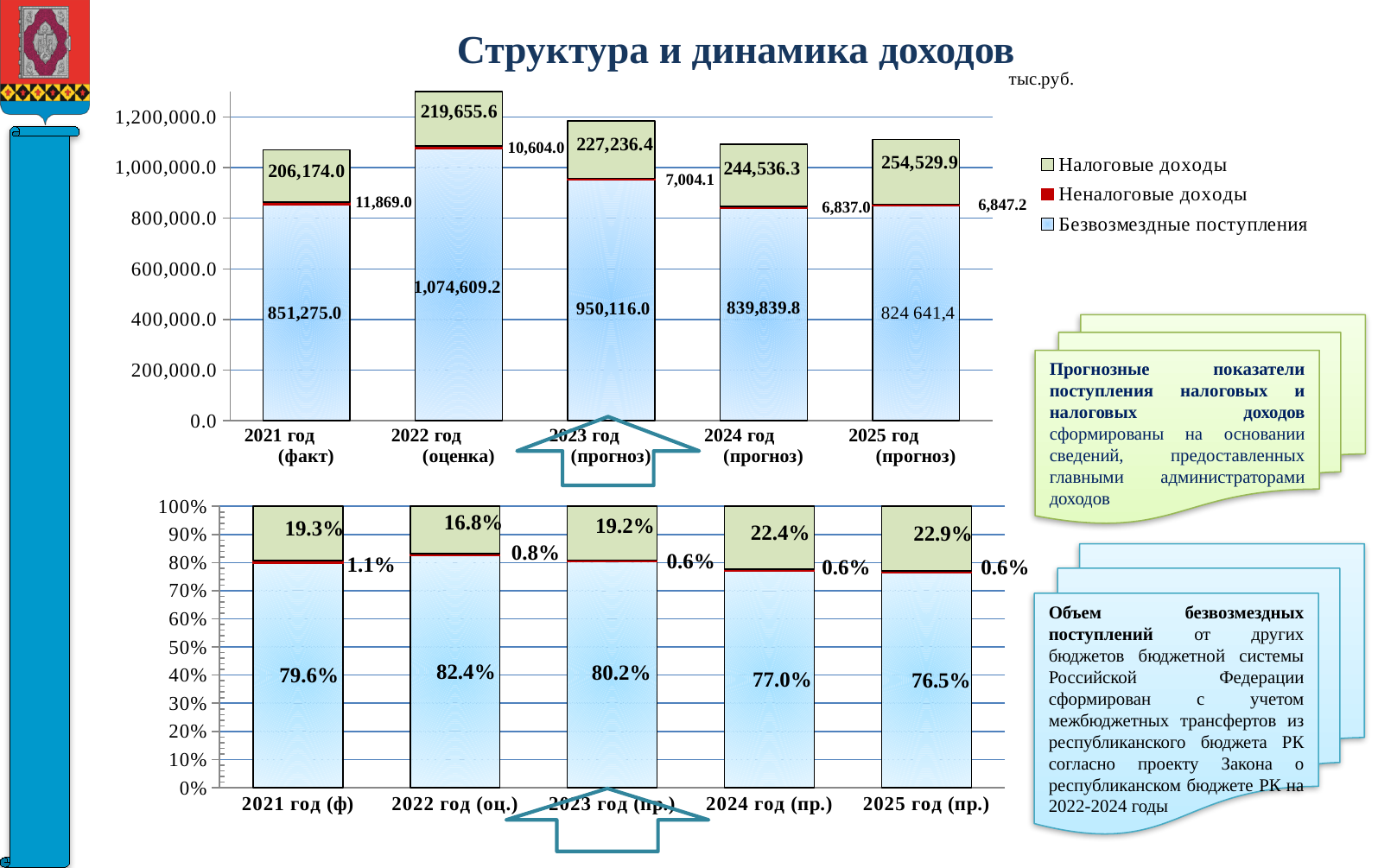
In the top chart, what is the difference between Налоговые доходы in 2025 год (прогноз) and in 2021 год (факт)? 48,355.9 In the bottom chart, which year has the lowest share of Налоговые доходы? 2022 год (оц.) In the bottom chart, what is the share of Безвозмездные поступления for 2024 год (пр.)? 77.0% In the top chart, what is the total of the stacked bar for 2021 год (факт)? 1,069,318.0 In the top chart, is the total of the 2024 год (прогноз) bar greater or less than 1,000,000.0? greater In the top chart, what is the value of Неналоговые доходы for 2022 год (оценка)? 10,604.0 In the top chart, which year has the highest value of Безвозмездные поступления? 2022 год (оценка) How many series does the legend list? 3 In the top chart, what is the value of Безвозмездные поступления for 2023 год (прогноз)? 950,116.0 In the top chart, what is the value of Налоговые доходы for 2021 год (факт)? 206,174.0 In the bottom chart, which is larger: the share of Безвозмездные поступления in 2022 год (оц.) or in 2023 год (пр.)? 2022 год (оц.) In the top chart, do the values of Налоговые доходы rise or fall from 2021 to 2025? rise